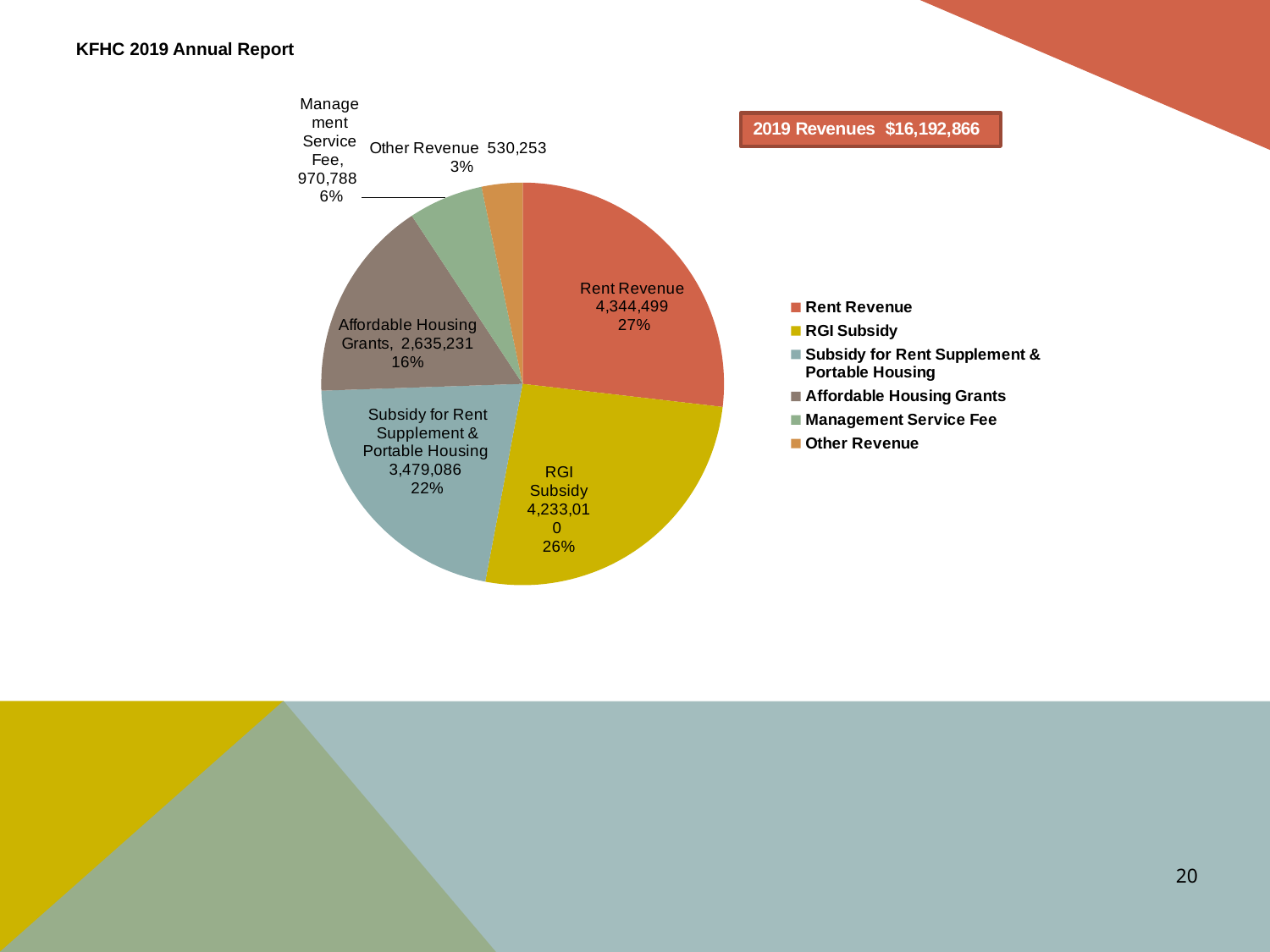
What is the value shown for Rent Revenue in the pie chart? 4,344,499 Which category has the smallest slice in the pie chart? Other Revenue What is the value shown for Affordable Housing Grants in the pie chart? 2,635,231 Which is larger, Subsidy for Rent Supplement & Portable Housing or Affordable Housing Grants? Subsidy for Rent Supplement & Portable Housing Which category has the largest slice in the pie chart? Rent Revenue What type of chart is shown on the slide? Pie chart How many categories are shown in the pie chart? 6 What is the value shown for RGI Subsidy in the pie chart? 4,233,010 What percentage share of the pie does Other Revenue represent? 3% What is the difference between the Affordable Housing Grants value and the Management Service Fee value? 1,664,443 What percentage share of the pie does Subsidy for Rent Supplement & Portable Housing represent? 22% What is the difference between the Rent Revenue value and the RGI Subsidy value? 111,489